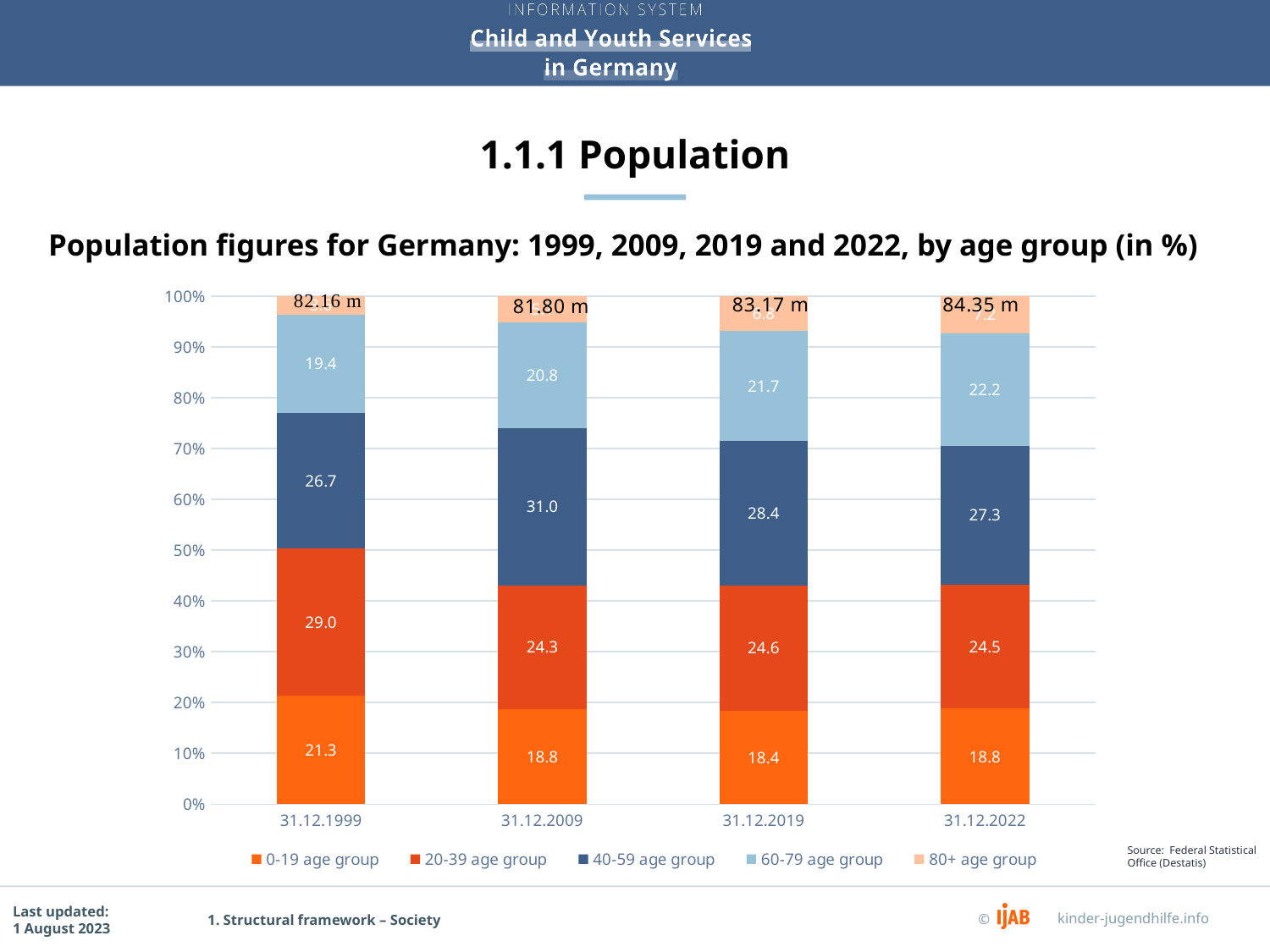
How many dates (categories) are shown on the x axis? 4 What is the value for the 40-59 age group on 31.12.2009? 31.0 What is the difference between the 40-59 age group values on 31.12.2009 and 31.12.1999? 4.3 What type of chart is shown on the slide? Stacked bar chart What is the value for the 0-19 age group on 31.12.1999? 21.3 What total population figure is printed above the bar for 31.12.2022? 84.35 m What is the value for the 60-79 age group on 31.12.2022? 22.2 On which date is the 20-39 age group share highest? 31.12.1999 On which date is the 0-19 age group share lowest? 31.12.2019 What is the value for the 20-39 age group on 31.12.2019? 24.6 How many series does the legend list? 5 Which is larger: the 60-79 age group value on 31.12.1999 or on 31.12.2009? 31.12.2009